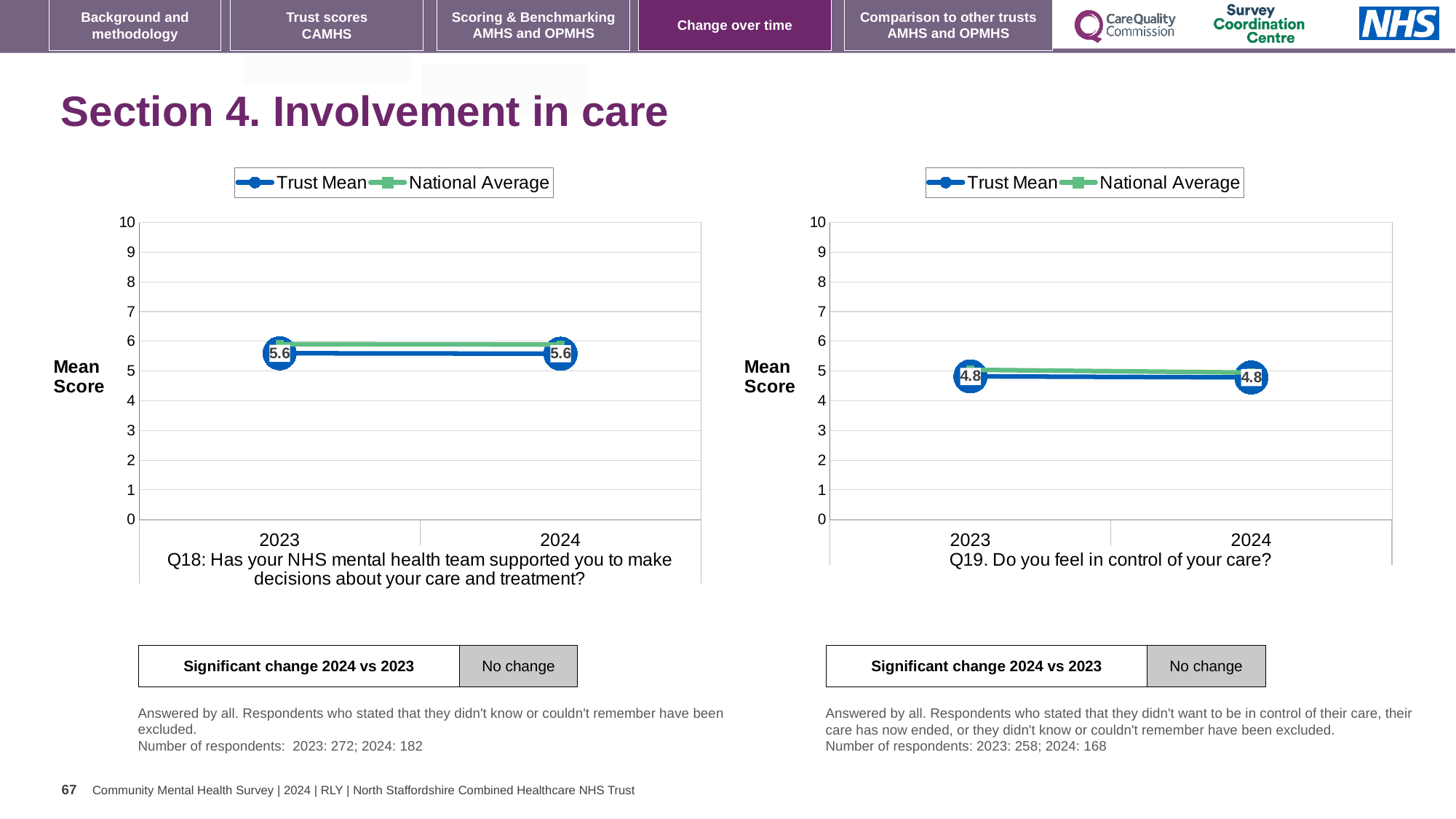
What kind of chart is the Q18 chart on the left? Line chart What is the y-axis label on the Q19 chart on the right? Mean Score In the Q18 chart on the left, what is the Trust Mean score for 2024? 5.6 In the Q19 chart on the right, what is the Trust Mean score for 2024? 4.8 In the Q18 chart on the left, is the National Average for 2023 greater or less than 5? greater In the Q18 chart on the left, which is higher in 2024, the Trust Mean or the National Average? National Average How many years are plotted on the x axis of the Q18 chart on the left? 2 In the Q18 chart on the left, does the Trust Mean rise, fall or stay the same from 2023 to 2024? Stays the same In the Q19 chart on the right, what is the Trust Mean score for 2023? 4.8 In the Q18 chart on the left, what is the Trust Mean score for 2023? 5.6 How many series does the legend of the Q19 chart on the right list? 2 In the Q19 chart on the right, what is the difference between the Trust Mean for 2024 and 2023? 0